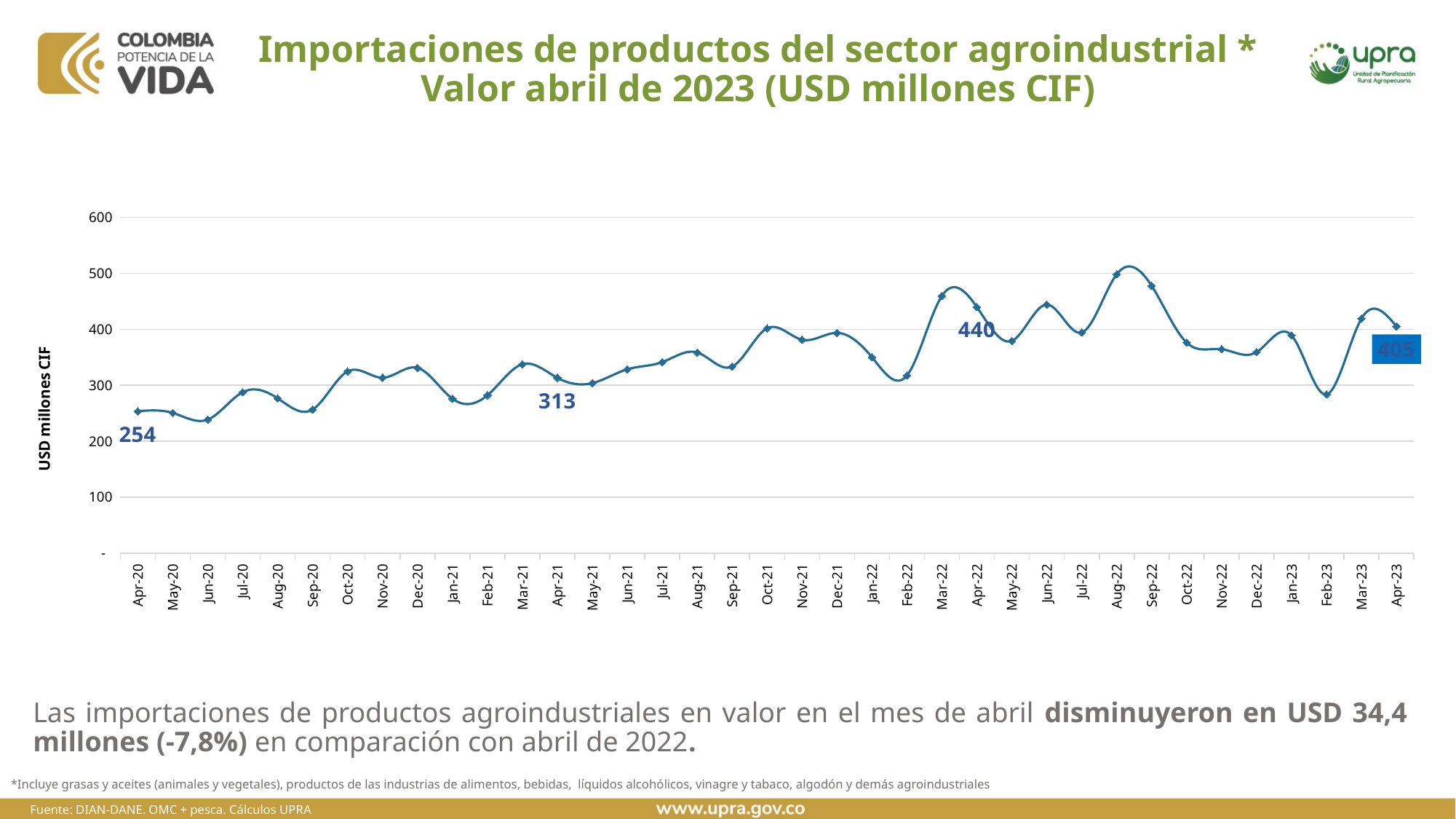
What type of chart is shown on the slide? Line chart Which month has the highest value on the chart? Aug-22 What is the value for Apr-22? 440 Is the value for Feb-23 greater or less than 300? less What is the value for Apr-21? 313 Which is larger, the value for Apr-22 or the value for Apr-23? Apr-22 What is the label on the vertical axis of the chart? USD millones CIF How many monthly data points are plotted on the chart? 37 What is the difference between the values for Apr-22 and Apr-21? 127 What is the value for Apr-23? 405 What is the value for Apr-20? 254 Which month has the lowest value on the chart? Jun-20